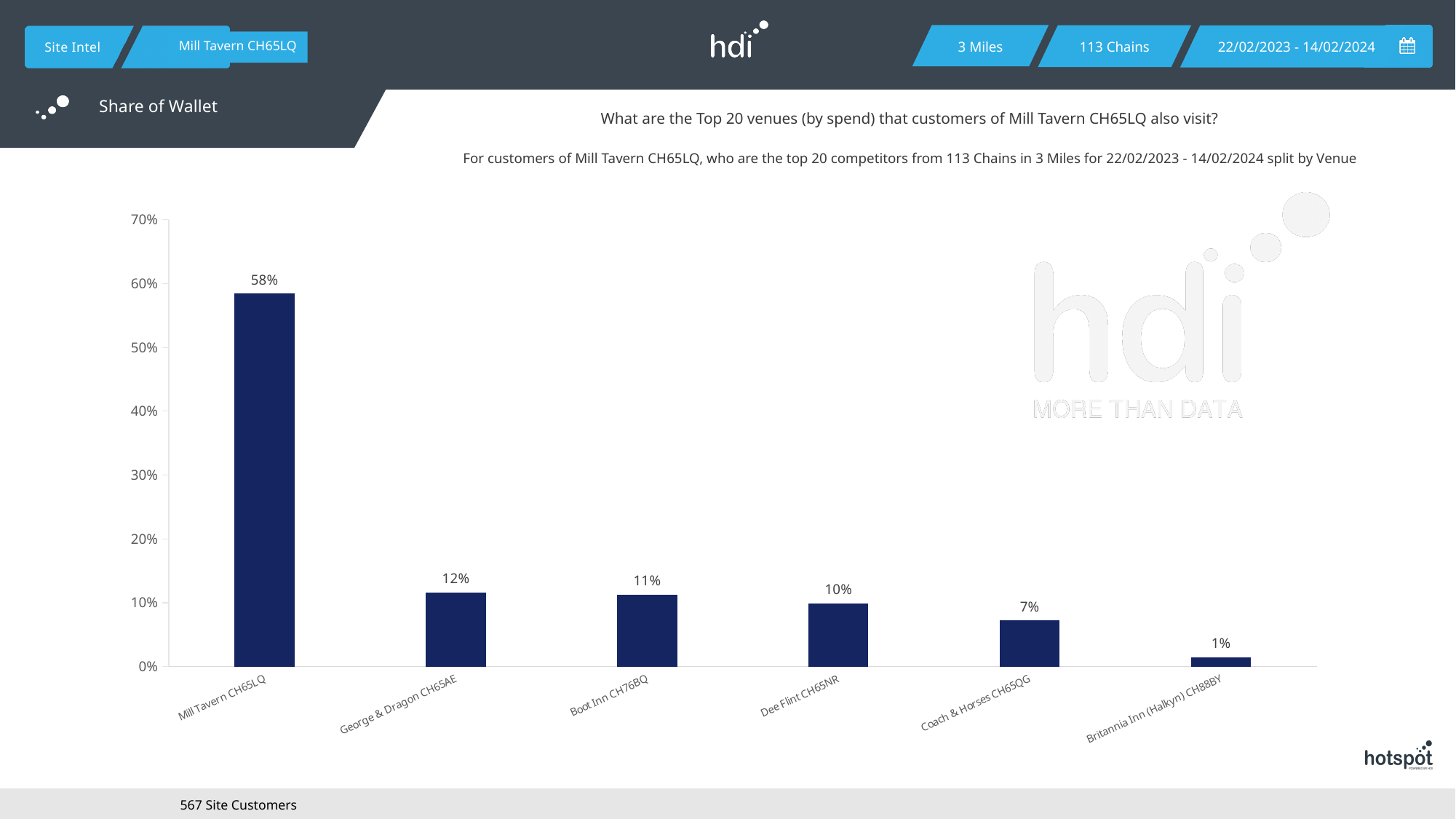
Do the values rise or fall from left to right along the x axis? fall What is the value for George & Dragon CH65AE? 12% How many venues are shown on the chart? 6 What is the difference between the values for Mill Tavern CH65LQ and George & Dragon CH65AE? 46% Is the value for Mill Tavern CH65LQ greater or less than 50%? greater What is the value for Boot Inn CH76BQ? 11% What is the value for Coach & Horses CH65QG? 7% Which venue has the highest value? Mill Tavern CH65LQ What kind of chart is shown on the slide? bar chart Which is larger, the value for Dee Flint CH65NR or the value for Coach & Horses CH65QG? Dee Flint CH65NR Which venue has the lowest value? Britannia Inn (Halkyn) CH88BY What is the value for Mill Tavern CH65LQ? 58%